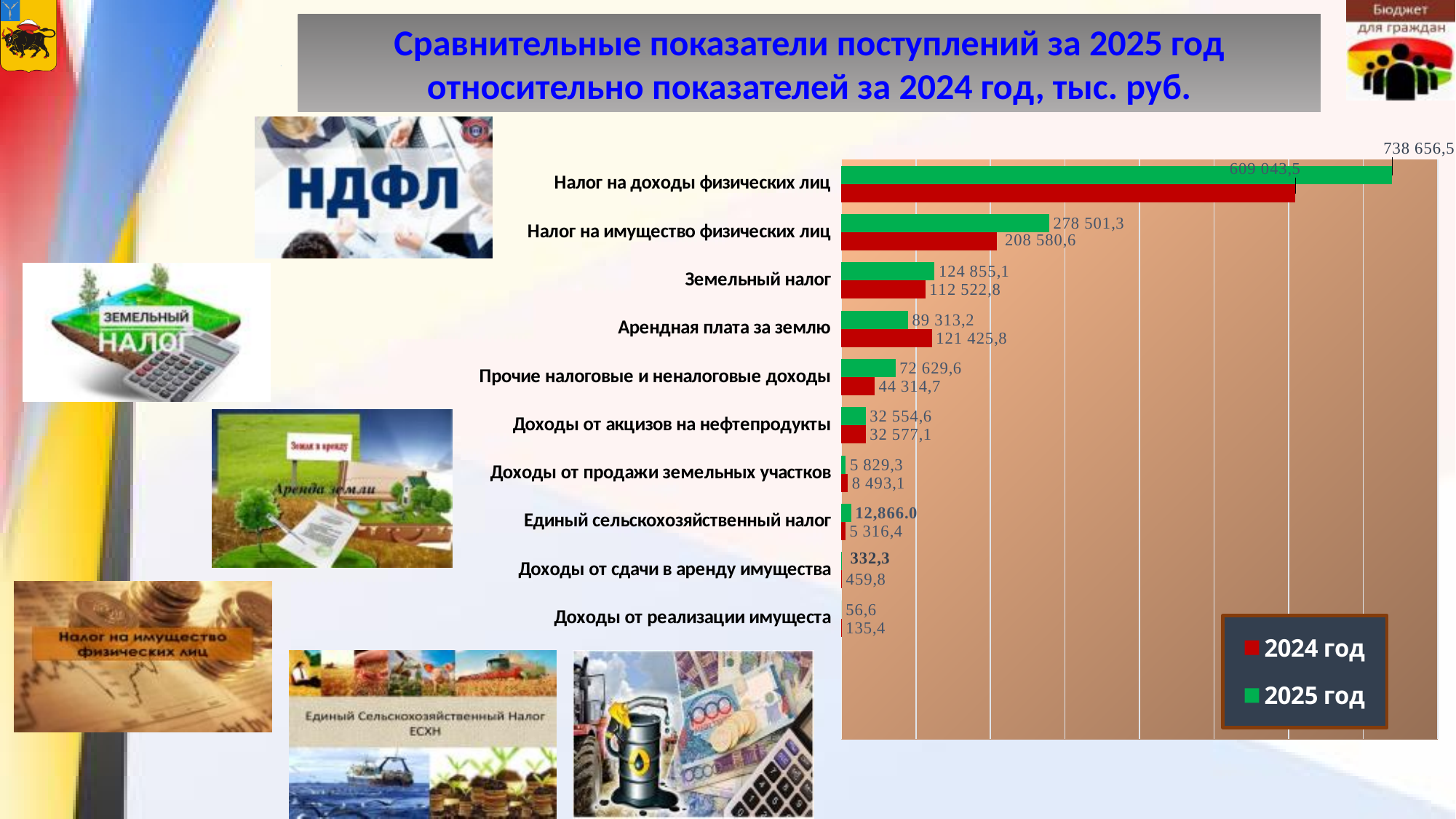
What is the 2025 год value for Доходы от реализации имущества? 56,6 For Прочие налоговые и неналоговые доходы, which is larger: the 2024 год value or the 2025 год value? 2025 год What type of chart is shown on the slide? bar chart How many series does the legend list? 2 How many categories are plotted on the chart? 10 What is the 2024 год value for Арендная плата за землю? 121 425,8 What is the 2025 год value for Налог на доходы физических лиц? 738 656,5 What is the 2024 год value for Налог на имущество физических лиц? 208 580,6 What is the difference between the 2025 год and 2024 год values for Земельный налог? 12 332,3 Which category has the lowest 2024 год value? Доходы от реализации имущества Which category has the highest 2025 год value? Налог на доходы физических лиц Which colour represents the 2024 год series in the legend? red